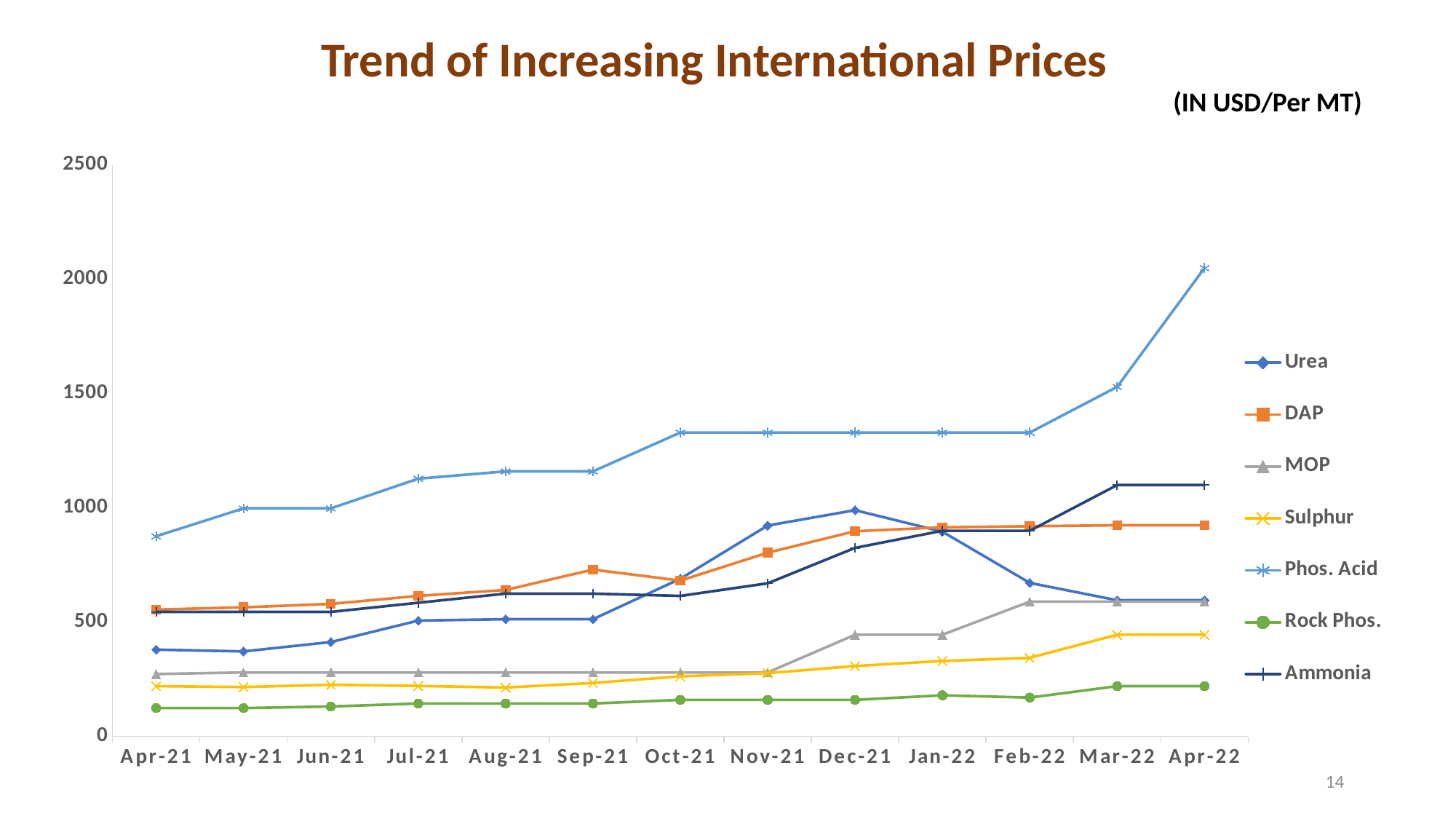
Is the value for Urea in Apr-21 greater or less than 500? less In Apr-22, which is higher, Ammonia or DAP? Ammonia How many series does the legend list? 7 Is the value for Ammonia in Mar-22 greater or less than 1000? greater Which series has the lowest value in Apr-22? Rock Phos. In which month does the Urea series reach its highest value? Dec-21 Does the Phos. Acid series rise or fall from Apr-21 to Apr-22? rise What type of chart is shown on the slide? line chart What unit is stated for the prices on the slide? USD/Per MT How many months are shown along the x axis? 13 Is the value for Phos. Acid in Apr-22 greater or less than 2000? greater Which series has the highest value in Apr-22? Phos. Acid